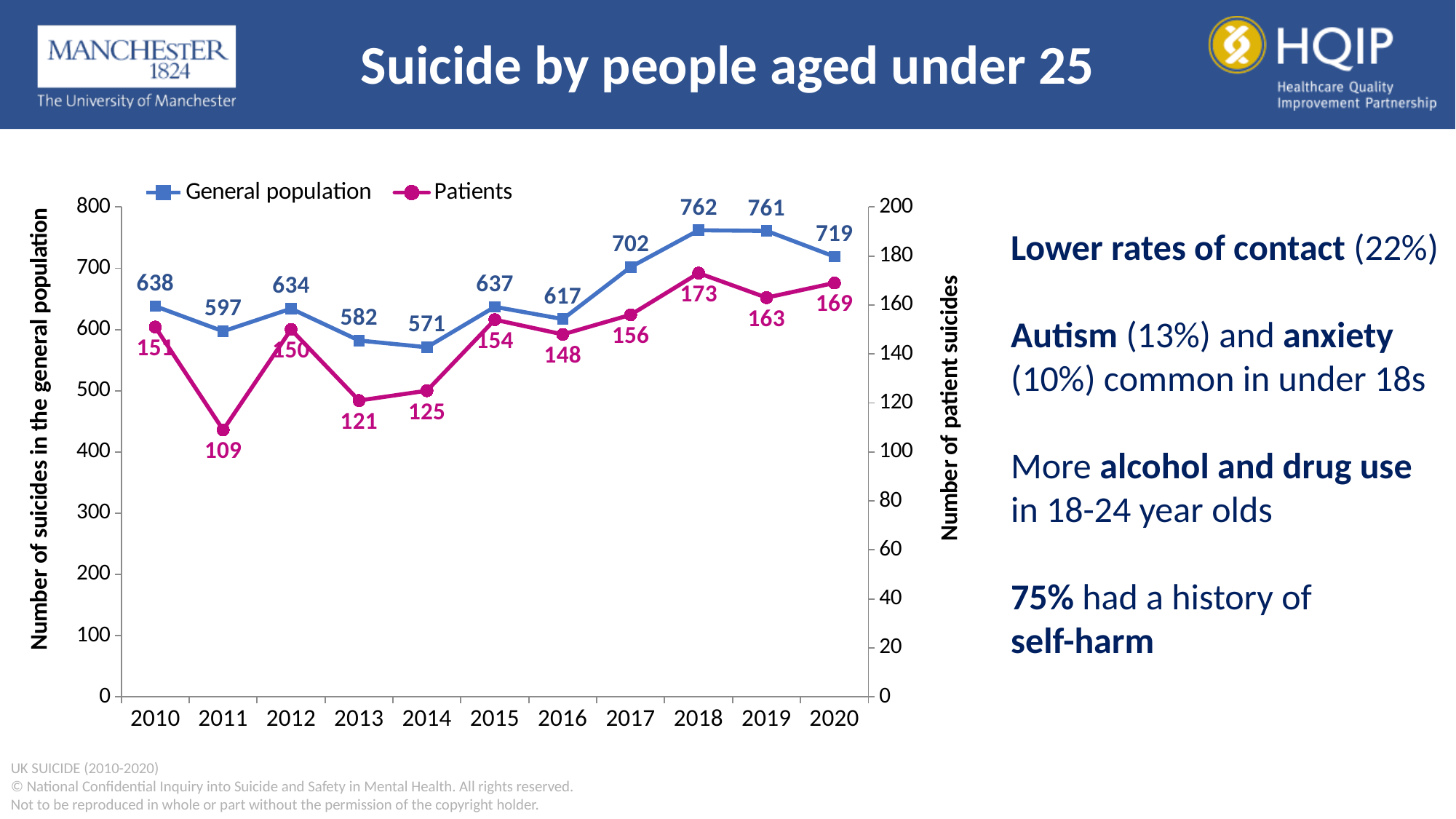
Which series is plotted with pink circle markers? Patients What is the General population value for 2014? 571 In which year is the Patients series at its highest? 2018 What is the difference between the General population values for 2018 and 2017? 60 What is the General population value for 2018? 762 Which is larger, the Patients value for 2019 or for 2020? 2020 How many years are plotted along the x axis of the chart? 11 What is the Patients value for 2011? 109 What type of chart is shown on the slide? Line chart In which year is the General population series at its lowest? 2014 What is the Patients value for 2020? 169 How many series does the chart legend list? 2